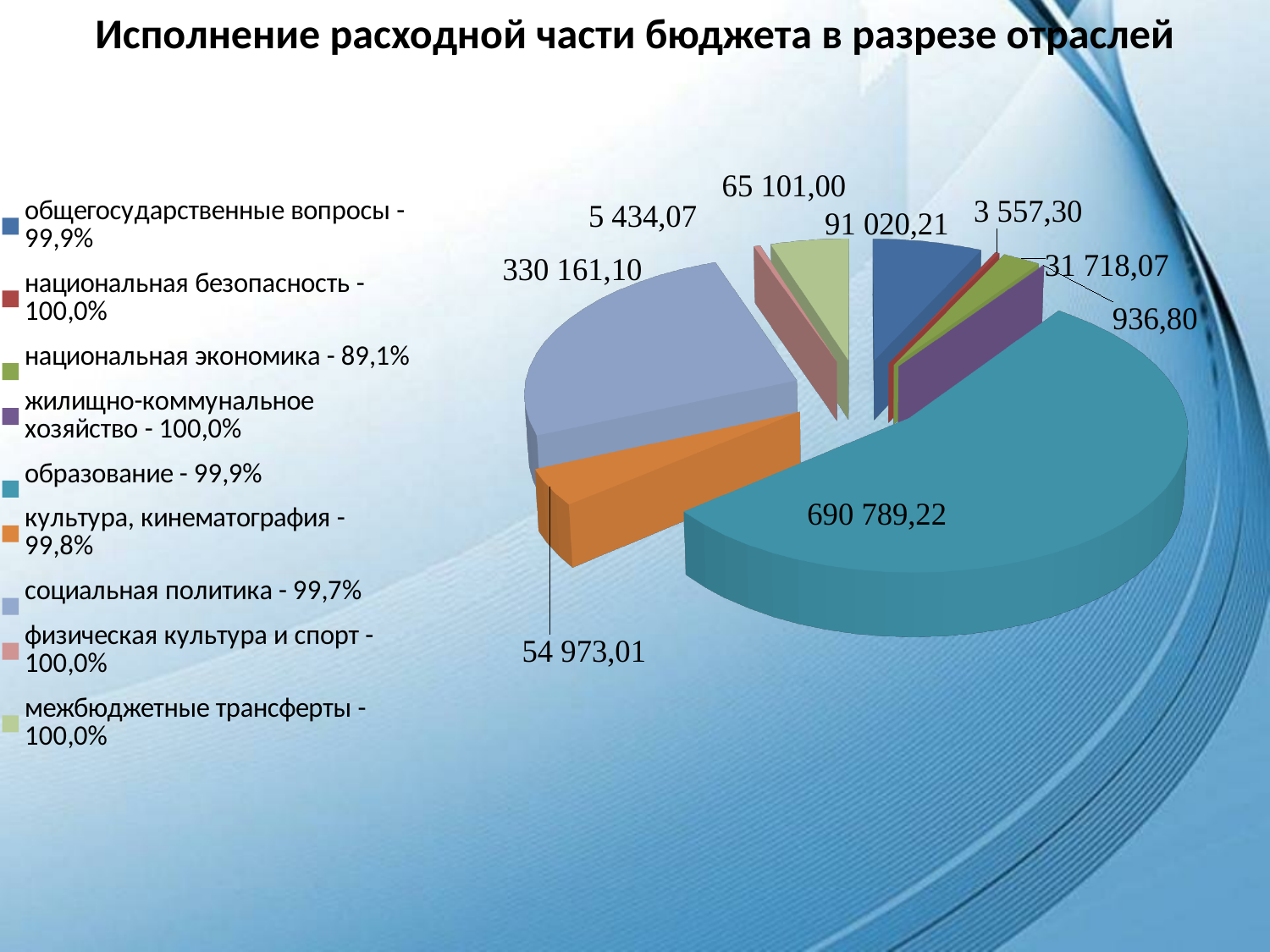
What is the value shown for общегосударственные вопросы? 91 020,21 What is the value shown for культура, кинематография? 54 973,01 Which category has the largest slice of the pie? образование What is the difference between the values for образование and социальная политика? 360 628,12 Which is larger, the value for культура, кинематография or the value for межбюджетные трансферты? межбюджетные трансферты What is the value shown for образование? 690 789,22 How many categories does the legend of the pie chart list? 9 What kind of chart is shown on the slide? pie chart What is the value shown for социальная политика? 330 161,10 What is the value shown for межбюджетные трансферты? 65 101,00 What execution percentage does the legend give for национальная экономика? 89,1% Which is larger, the value for образование or the value for социальная политика? образование